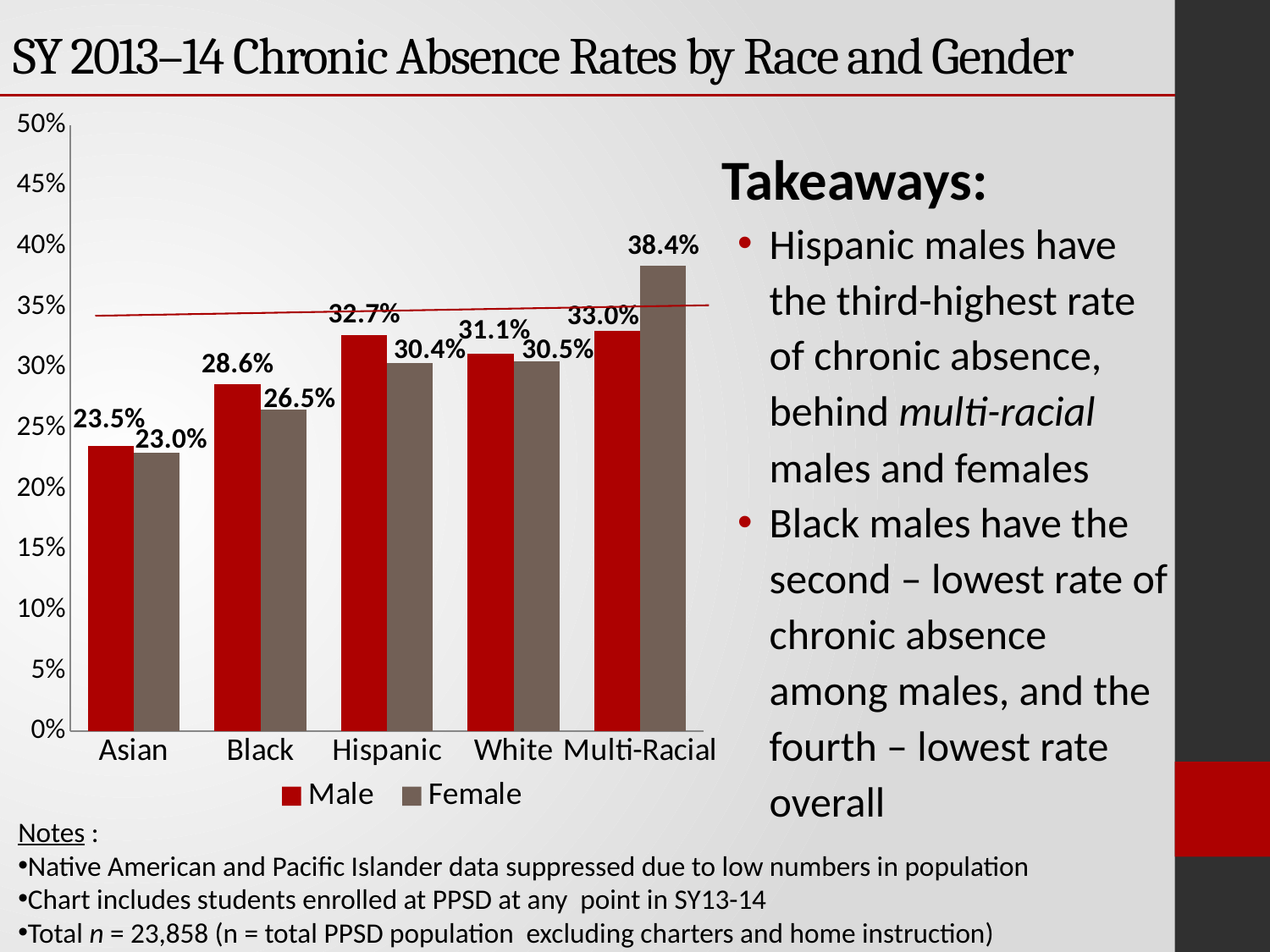
How many series does the legend list? 2 What is the chronic absence rate for Black females? 26.5% What is the chronic absence rate for Multi-Racial females? 38.4% What kind of chart is shown on the slide? bar chart What is the difference between the Multi-Racial female rate and the Multi-Racial male rate? 5.4% What is the chronic absence rate for Hispanic males? 32.7% Which is larger, the male rate for White students or the male rate for Hispanic students? Hispanic How many race categories are shown on the x axis? 5 Is the female chronic absence rate for Asian students greater or less than 25%? less Which race category has the lowest male chronic absence rate? Asian Which race category has the highest female chronic absence rate? Multi-Racial What is the difference between the male and female chronic absence rates for Black students? 2.1%